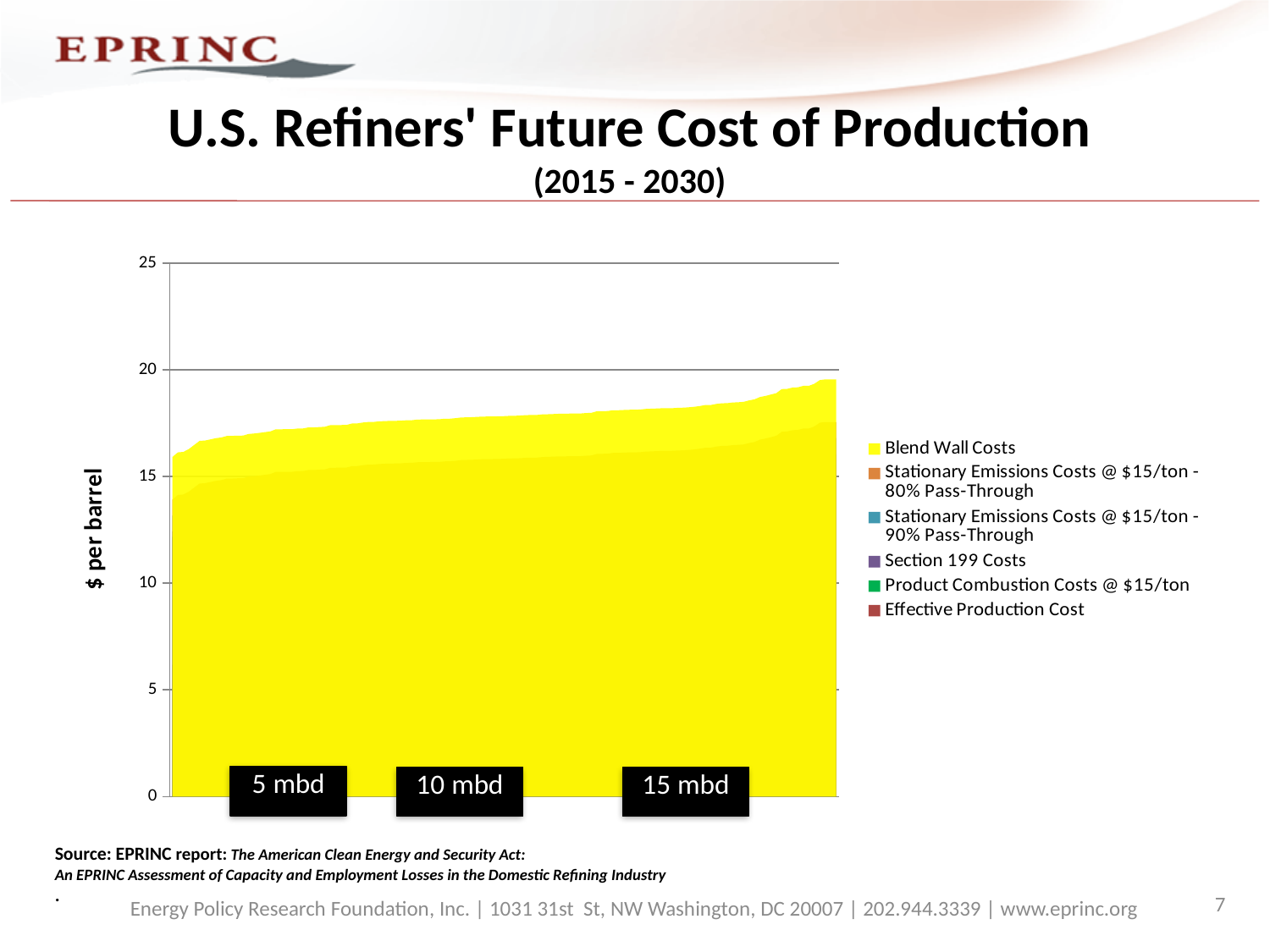
What is the highest value shown on the vertical axis of the chart? 25 Is the total cost per barrel at the right edge of the chart greater or less than 15? greater How many capacity labels (mbd) are shown along the bottom of the chart? 3 What kind of chart is shown on the slide? Area chart How many series does the legend list? 6 What is the title of the chart on the slide? U.S. Refiners' Future Cost of Production (2015 - 2030) Does the total cost per barrel rise or fall moving from left to right across the chart? Rise What is the label on the vertical axis of the chart? $ per barrel Is the total cost per barrel at the left edge of the chart greater or less than 20? less Is the total cost per barrel at the left edge of the chart greater or less than 15? greater